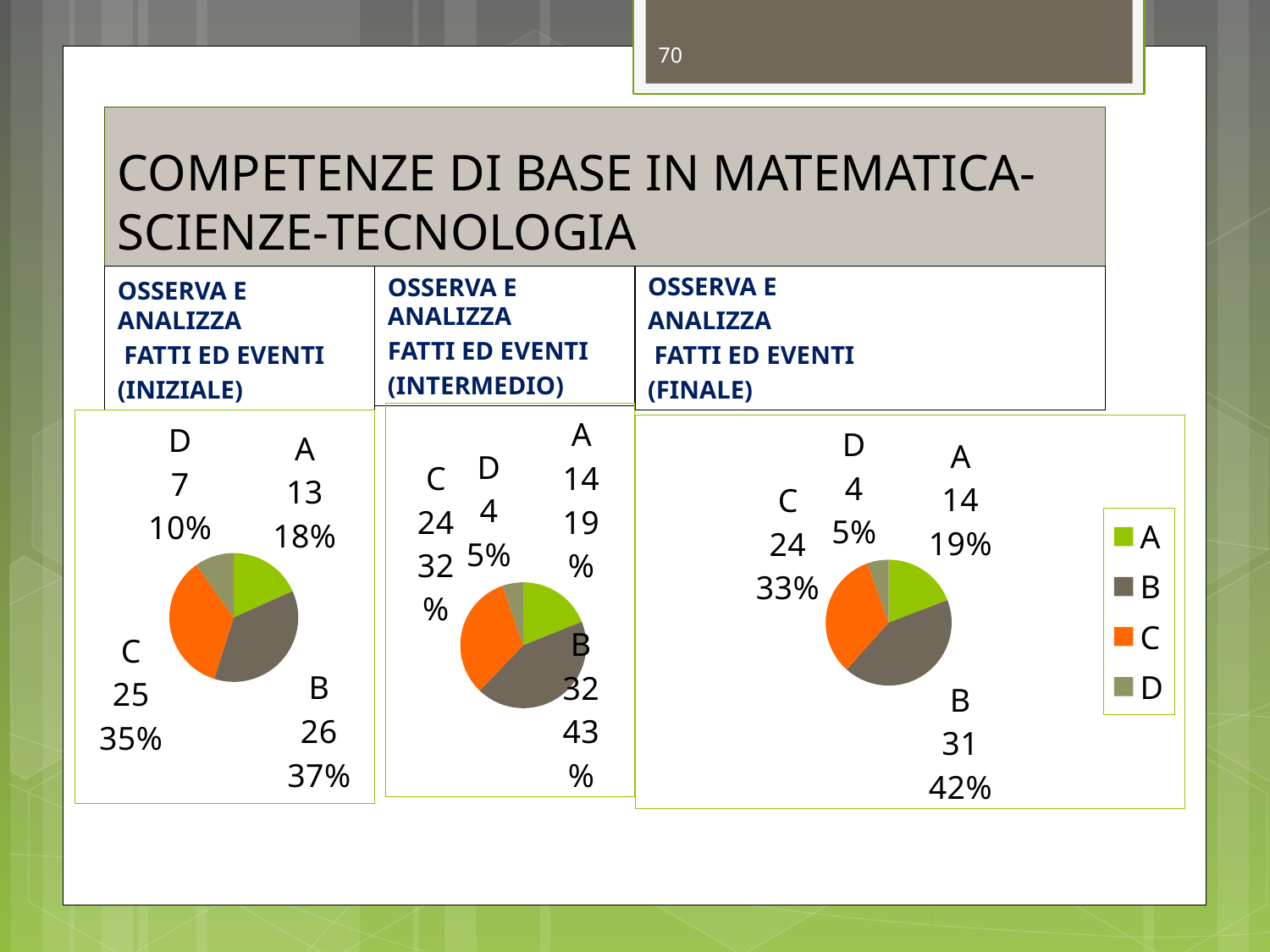
In the INIZIALE pie chart, which category has the smallest value? D How many categories does the INIZIALE pie chart show? 4 What type of chart is used for the FINALE data? Pie chart In the INIZIALE pie chart, what percentage share does category C have? 35% In the INIZIALE pie chart, what value is shown for category B? 26 In the INTERMEDIO pie chart, what percentage share does category D have? 5% In the FINALE pie chart, what percentage share does category B have? 42% In the FINALE pie chart, what is the difference between the values for B and A? 17 In the INTERMEDIO pie chart, what value is shown for category B? 32 In the INTERMEDIO pie chart, which category has the largest value? B In the FINALE pie chart, which is larger, the value for C or the value for A? C In the FINALE pie chart, what value is shown for category C? 24